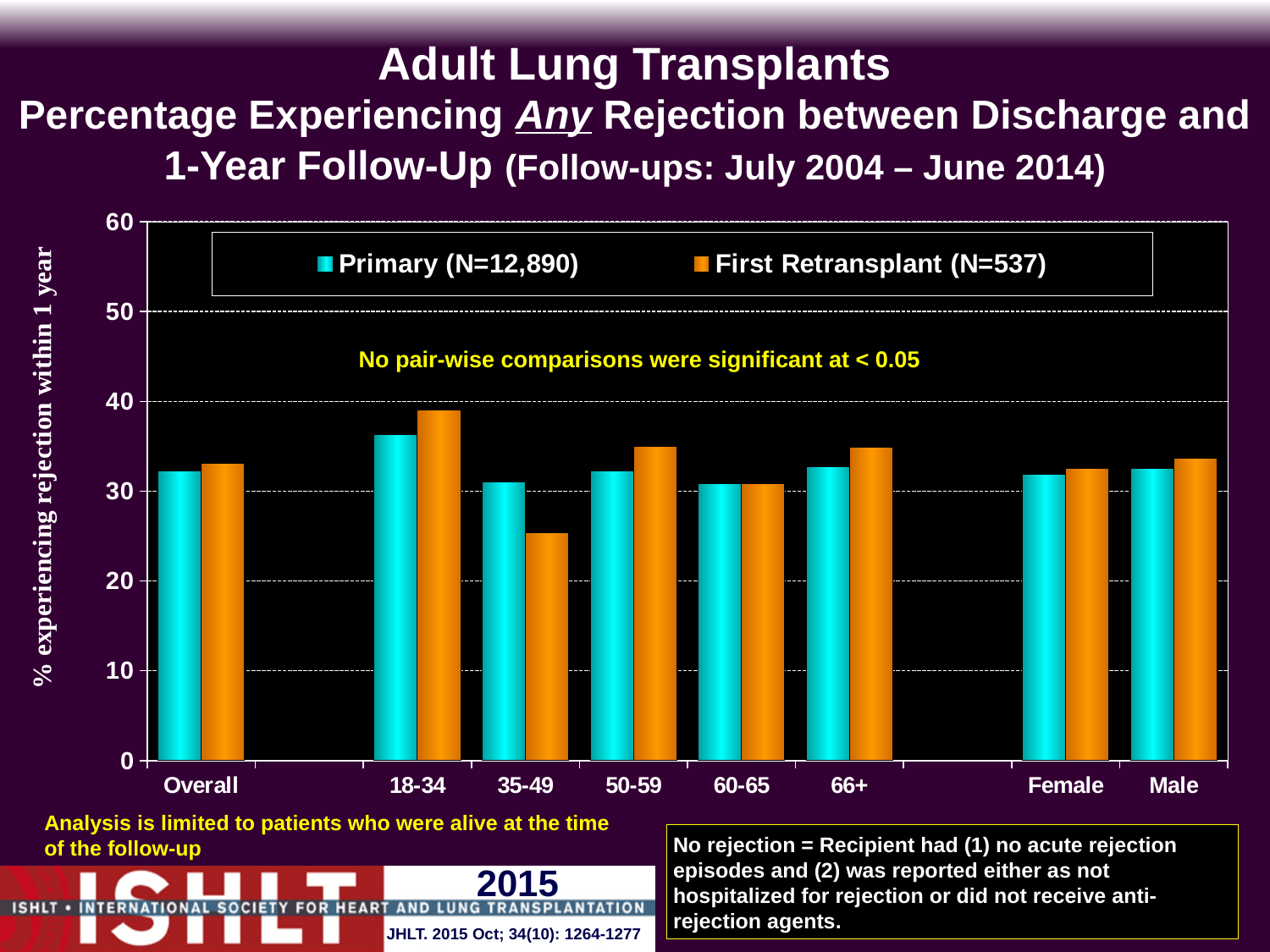
Which category has the highest value for the Primary series? 18-34 Is the First Retransplant value for 35-49 greater or less than 30? less What kind of chart is shown on the slide? bar chart How many series does the legend list? 2 For the 50-59 category, which series has the larger value, Primary or First Retransplant? First Retransplant Is the First Retransplant value for 18-34 greater or less than 40? less Which category has the highest value for the First Retransplant series? 18-34 Which category has the lowest value for the First Retransplant series? 35-49 What is the N shown in the legend for the Primary series? 12,890 How many categories are shown along the x axis? 8 For the 35-49 category, which series has the larger value, Primary or First Retransplant? Primary Is the Primary value for 18-34 greater or less than 30? greater